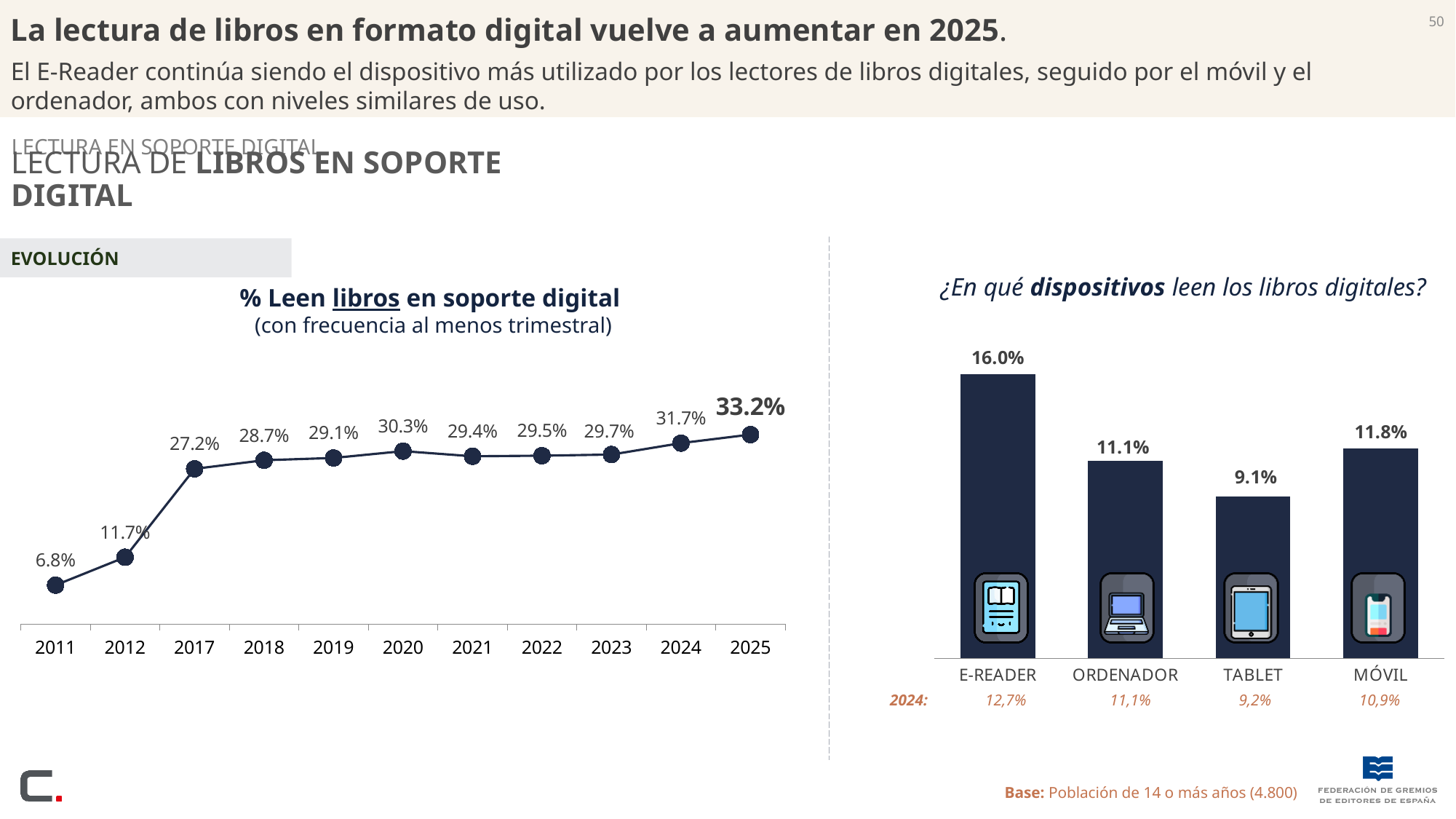
In the '% Leen libros en soporte digital' chart, which year has the highest value? 2025 In the '% Leen libros en soporte digital' chart, what is the difference between the 2025 and 2024 values? 1.5% In the '% Leen libros en soporte digital' chart, how many years are plotted? 11 In the '¿En qué dispositivos leen los libros digitales?' chart, which device has the lowest value? TABLET In the '% Leen libros en soporte digital' chart, which year has the lowest value? 2011 In the '% Leen libros en soporte digital' chart, what is the value for 2011? 6.8% In the '¿En qué dispositivos leen los libros digitales?' chart, what is the value for E-READER? 16.0% In the '% Leen libros en soporte digital' chart, do the values generally rise or fall from 2011 to 2025? rise What kind of chart is the '% Leen libros en soporte digital' chart? line chart In the '% Leen libros en soporte digital' chart, what is the value for 2025? 33.2% In the '¿En qué dispositivos leen los libros digitales?' chart, what is the difference between E-READER and TABLET? 6.9% In the '¿En qué dispositivos leen los libros digitales?' chart, which is larger, ORDENADOR or MÓVIL? MÓVIL